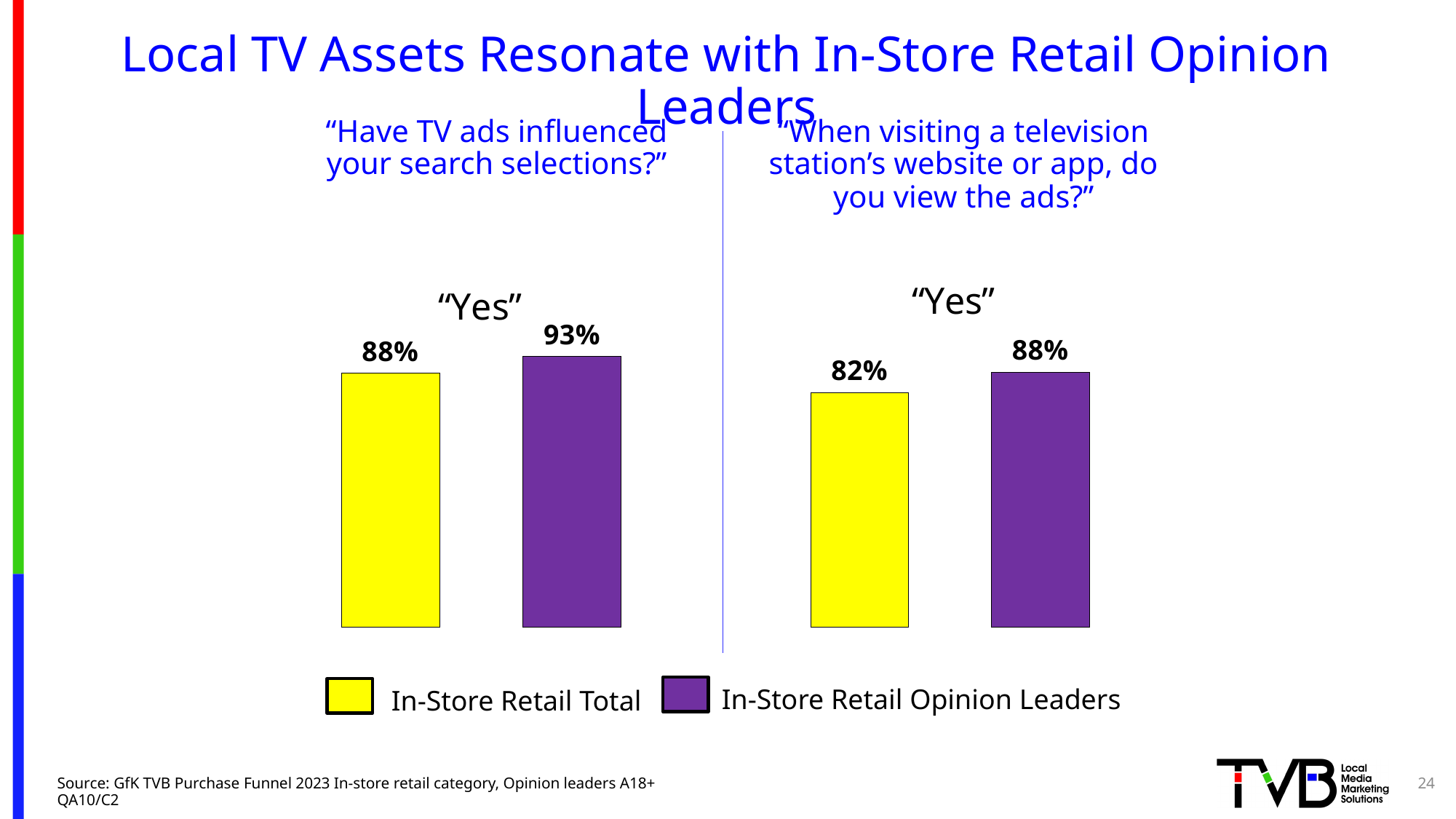
Which colour represents In-Store Retail Opinion Leaders in the legend? Purple In the left chart ("Have TV ads influenced your search selections?"), what percentage of In-Store Retail Opinion Leaders answered "Yes"? 93% What kind of chart is used on this slide? Bar chart In the left chart ("Have TV ads influenced your search selections?"), what percentage of In-Store Retail Total answered "Yes"? 88% In the right chart ("When visiting a television station's website or app, do you view the ads?"), what is the value for In-Store Retail Total? 82% In the right chart ("When visiting a television station's website or app, do you view the ads?"), what is the value for In-Store Retail Opinion Leaders? 88% In the left chart, what is the difference in percentage points between In-Store Retail Opinion Leaders and In-Store Retail Total? 5 percentage points How many bars are shown in the right chart? 2 How many series does the legend list? 2 In the right chart, which group has the lower "Yes" percentage? In-Store Retail Total In the left chart, which group has the higher "Yes" percentage? In-Store Retail Opinion Leaders In the right chart, what is the difference in percentage points between In-Store Retail Opinion Leaders and In-Store Retail Total? 6 percentage points